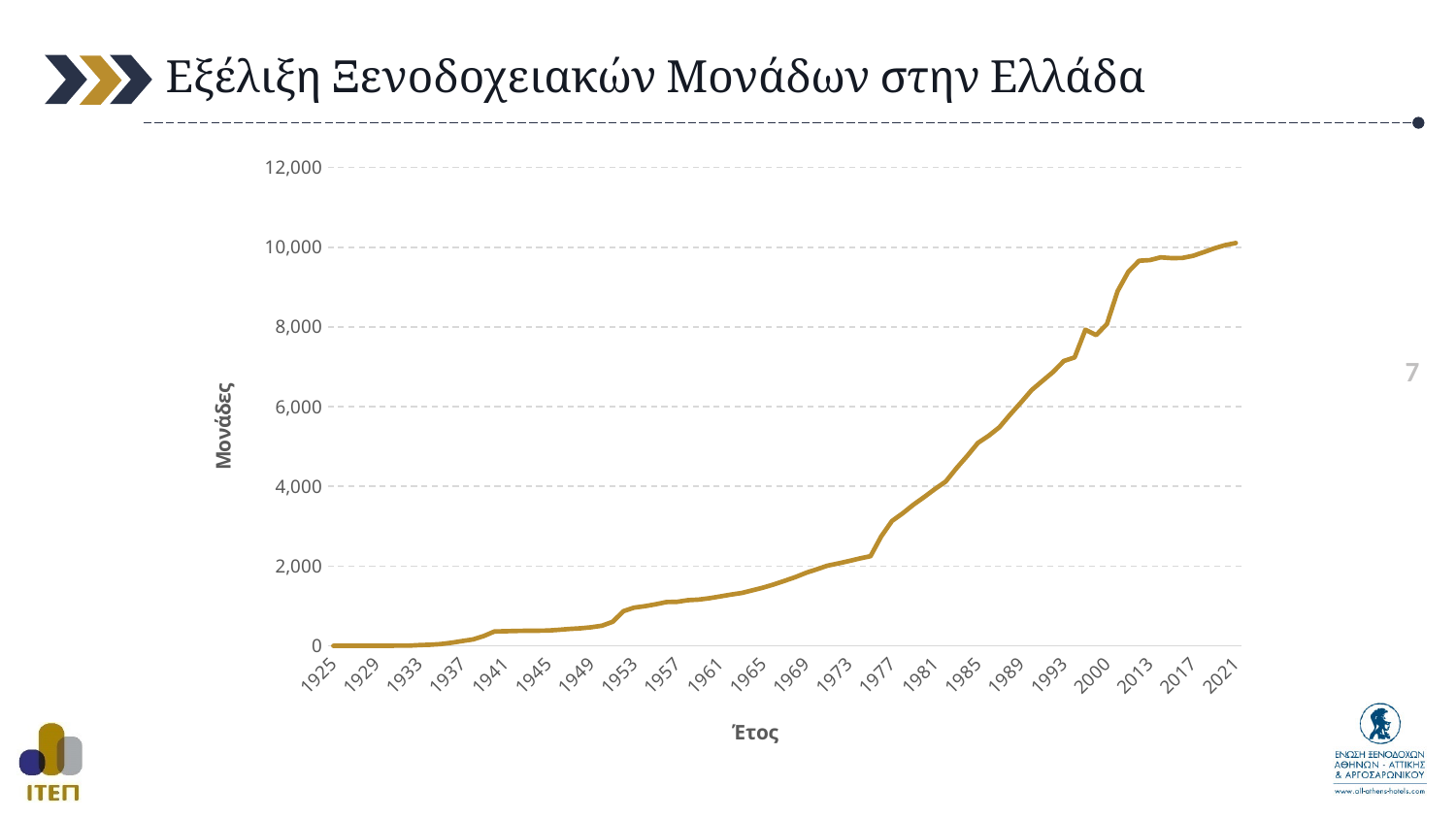
Do the values generally rise or fall from 1925 to 2021? rise What kind of chart is shown on the slide? line chart Is the value for 2021 greater or less than 8,000? greater Which year has the highest value on the chart? 2021 Which year has the larger value, 1965 or 1993? 1993 Is the value for 1953 greater or less than 2,000? less What is the title of the chart? Εξέλιξη Ξενοδοχειακών Μονάδων στην Ελλάδα What is the label of the vertical axis? Μονάδες Is the value for 1985 greater or less than 4,000? greater